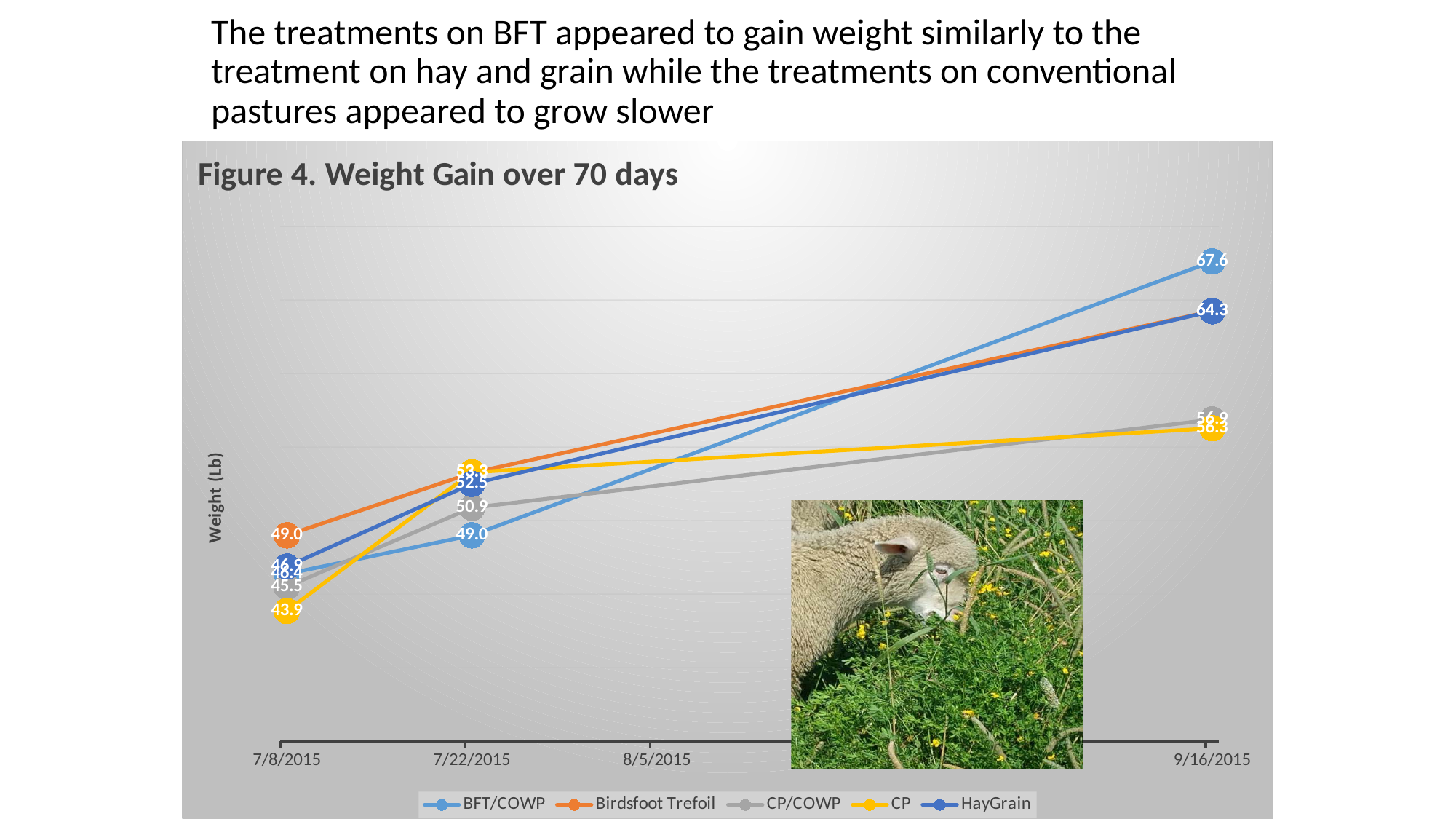
What is the weight for CP/COWP on 7/22/2015? 50.9 By how much did the weight for BFT/COWP increase from 7/8/2015 to 9/16/2015? 21.2 Does the weight for CP rise or fall from 7/8/2015 to 9/16/2015? rise What is the weight for CP on 7/8/2015? 43.9 What is the title of the chart? Figure 4. Weight Gain over 70 days Which series has the highest weight on 9/16/2015? BFT/COWP What is the weight for HayGrain on 7/22/2015? 52.5 Which series has the lowest weight on 7/8/2015? CP What is the weight for BFT/COWP on 9/16/2015? 67.6 How many series does the legend of the Weight Gain chart list? 5 What kind of chart is shown in Figure 4? line chart What is the label on the vertical axis of the chart? Weight (Lb)